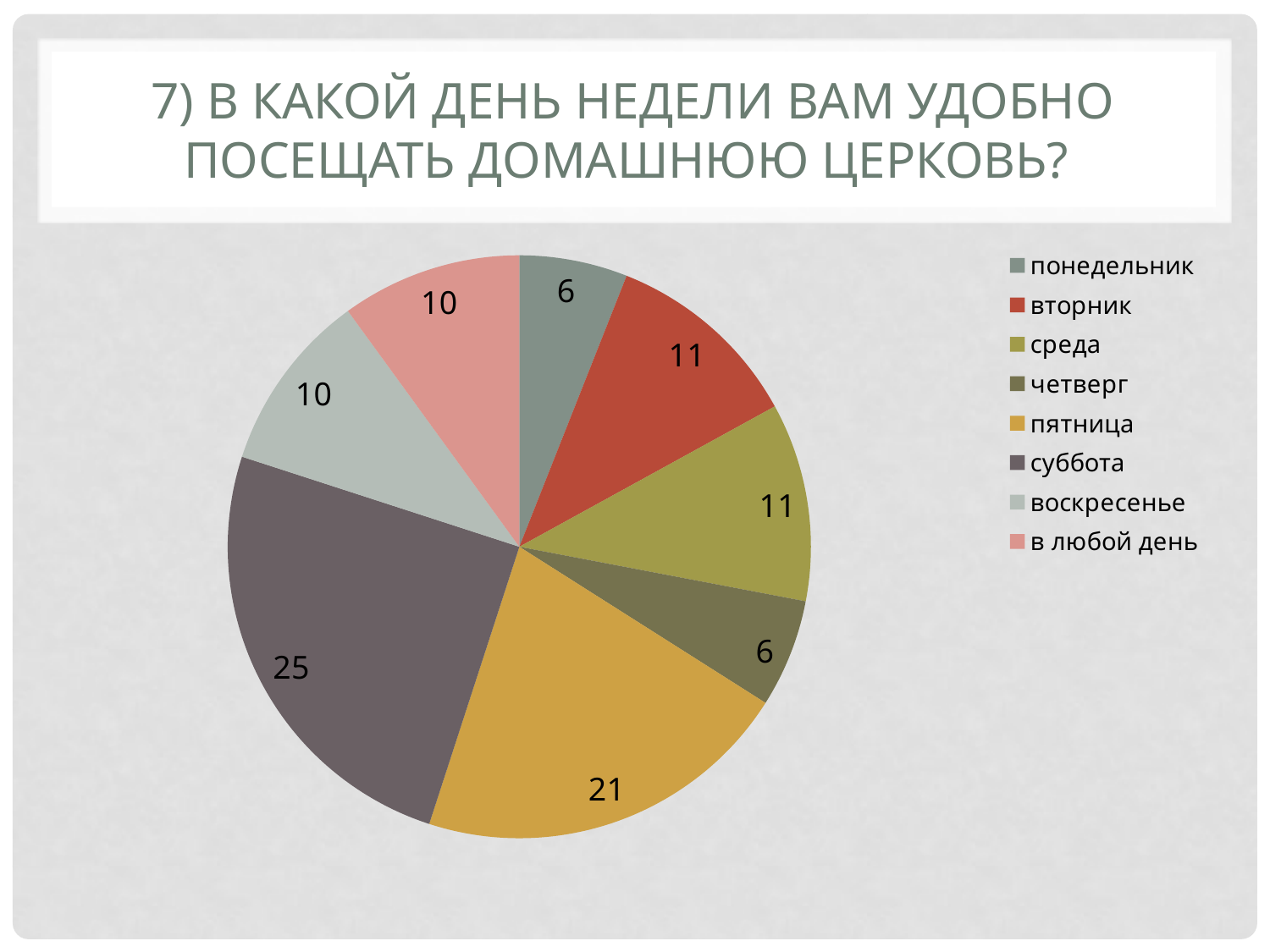
What is the value for вторник? 11 What kind of chart is shown on the slide? pie chart Which legend entry is listed last? в любой день How many slices does the pie chart have? 8 Which is larger, the value for пятница or the value for среда? пятница What is the difference between the values for суббота and пятница? 4 What share of the pie does суббота represent? 25% What is the value for пятница? 21 What is the value for воскресенье? 10 What is the difference between the values for вторник and понедельник? 5 What is the value for суббота? 25 Which category has the largest slice? суббота